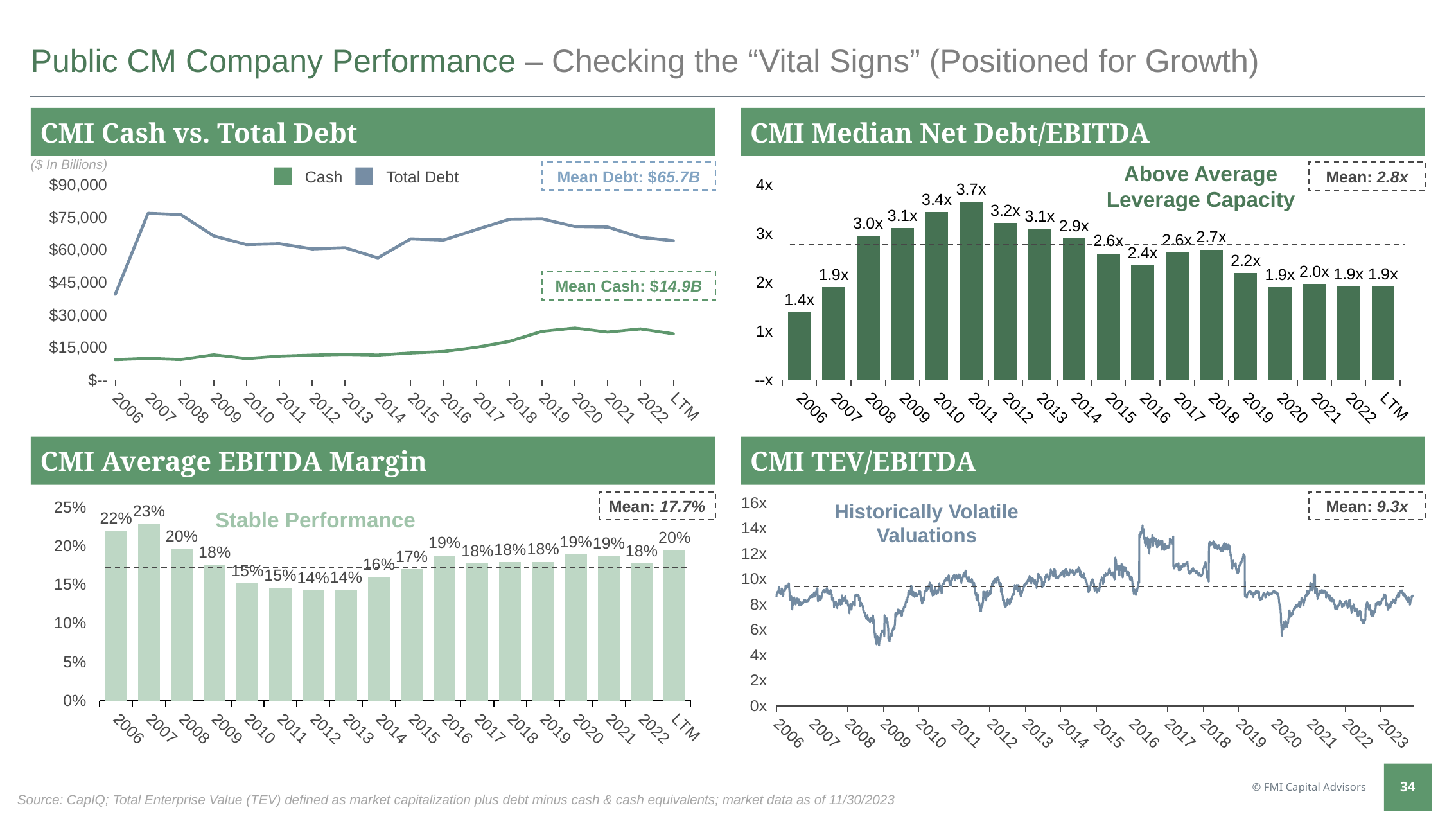
In the CMI Median Net Debt/EBITDA chart, what is the difference between the 2011 value and the 2006 value? 2.3x In the CMI Median Net Debt/EBITDA chart, which is larger, the value for 2008 or the value for 2016? 2008 How many series does the legend of the CMI Cash vs. Total Debt chart list? 2 In the CMI Median Net Debt/EBITDA chart, which year has the lowest value? 2006 What kind of chart is the CMI Cash vs. Total Debt chart? Line chart In the CMI Cash vs. Total Debt chart, is the Total Debt value for 2007 greater or less than $60,000? greater In the CMI Median Net Debt/EBITDA chart, which year has the highest value? 2011 In the CMI Average EBITDA Margin chart, which year has the highest margin? 2007 In the CMI Average EBITDA Margin chart, what is the value for LTM? 20% In the CMI Average EBITDA Margin chart, how many bars are plotted? 18 In the CMI Average EBITDA Margin chart, what is the value for 2007? 23% In the CMI Median Net Debt/EBITDA chart, what is the value for 2011? 3.7x